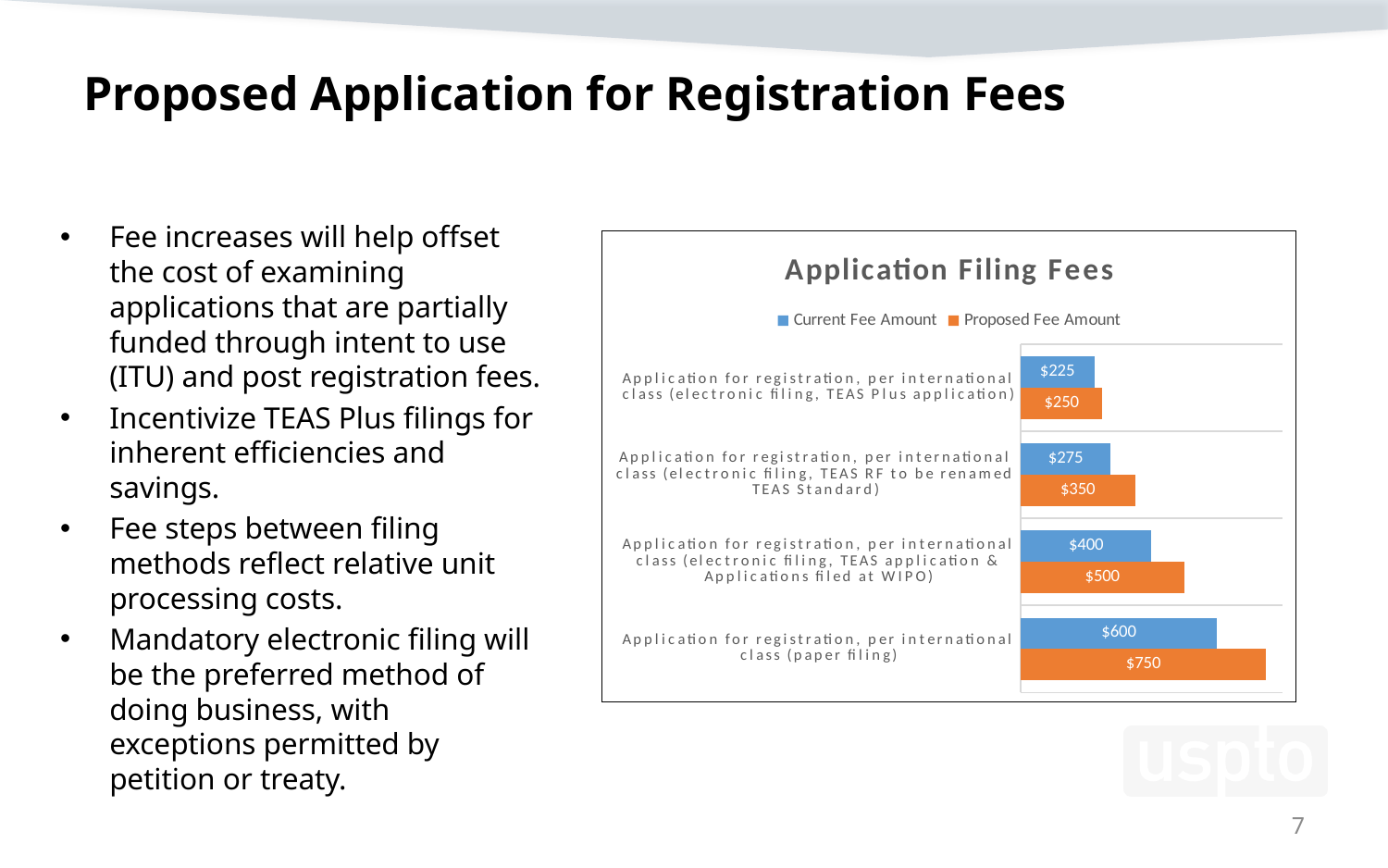
Which category has the lowest Current Fee Amount? Application for registration, per international class (electronic filing, TEAS Plus application) How many series does the legend of the Application Filing Fees chart list? 2 What is the difference between the Proposed Fee Amount and the Current Fee Amount for Application for registration, per international class (electronic filing, TEAS application & Applications filed at WIPO)? $100 What is the title of the chart on the slide? Application Filing Fees What kind of chart is the Application Filing Fees chart? Bar chart What is the Proposed Fee Amount for Application for registration, per international class (electronic filing, TEAS Plus application)? $250 What is the Current Fee Amount for Application for registration, per international class (paper filing)? $600 What is the difference between the Proposed Fee Amount and the Current Fee Amount for Application for registration, per international class (paper filing)? $150 How many categories are shown in the Application Filing Fees chart? 4 Which is larger: the Current Fee Amount for the paper filing category or the Proposed Fee Amount for the TEAS application & Applications filed at WIPO category? Current Fee Amount for paper filing What is the Proposed Fee Amount for Application for registration, per international class (electronic filing, TEAS RF to be renamed TEAS Standard)? $350 Which category has the highest Proposed Fee Amount? Application for registration, per international class (paper filing)